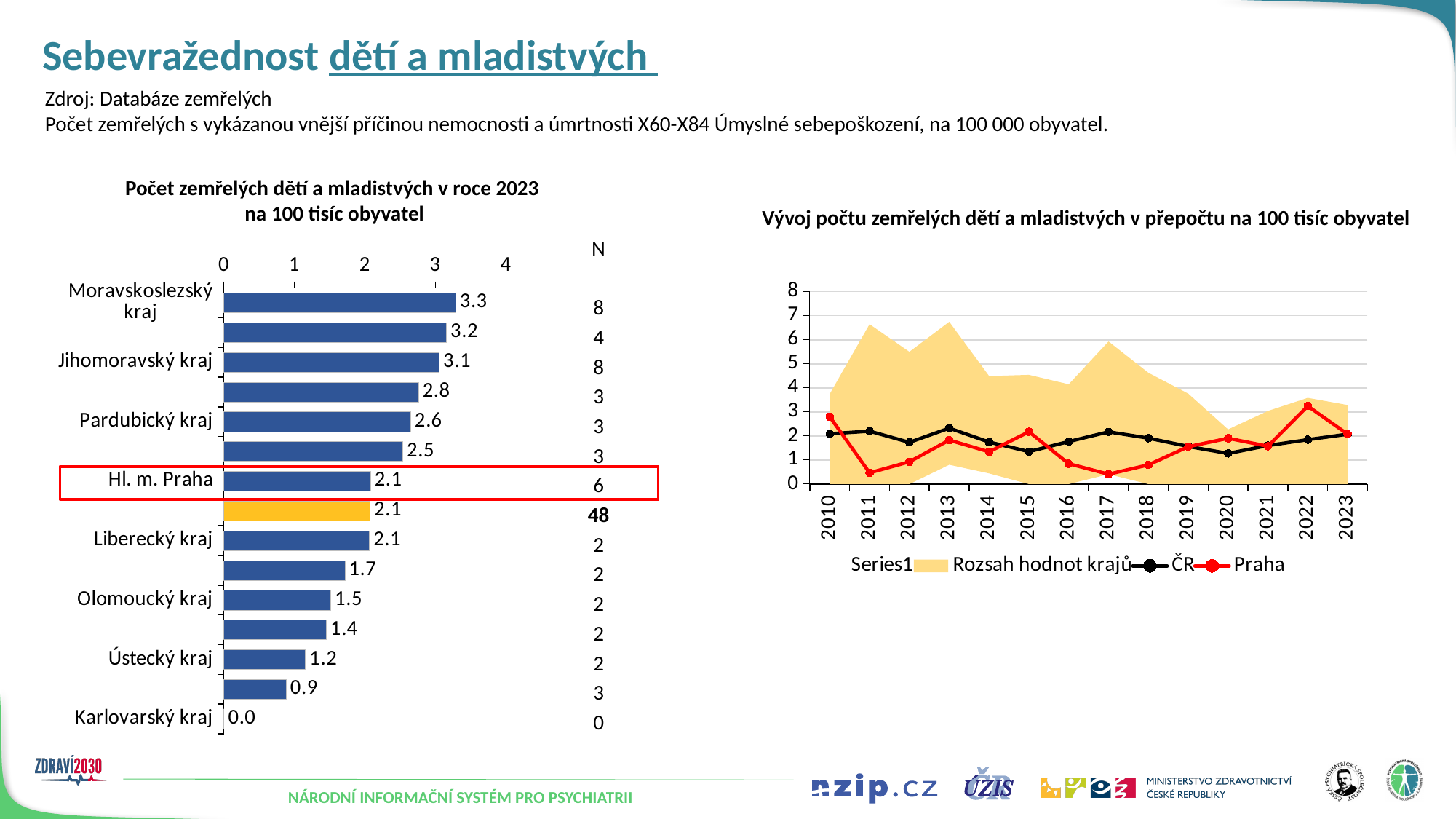
In the bar chart on the left, what is the N value shown next to Hl. m. Praha? 6 In the bar chart on the left, which is larger, the value for Pardubický kraj or the value for Liberecký kraj? Pardubický kraj In the bar chart on the left, what is the value for Moravskoslezský kraj? 3.3 In the bar chart on the left, which labelled region has the highest value? Moravskoslezský kraj In the chart on the right, is the value for Praha in 2022 greater or less than 3? greater In the chart on the right, how many years are shown on the x axis? 14 In the bar chart on the left, which labelled region has the lowest value? Karlovarský kraj In the bar chart on the left, what is the difference between the values for Jihomoravský kraj and Ústecký kraj? 1.9 What kind of chart is the chart on the left? bar chart In the bar chart on the left, what is the value for Hl. m. Praha? 2.1 In the chart on the right, is the value for Praha in 2011 greater or less than 1? less In the bar chart on the left, what is the value for Olomoucký kraj? 1.5